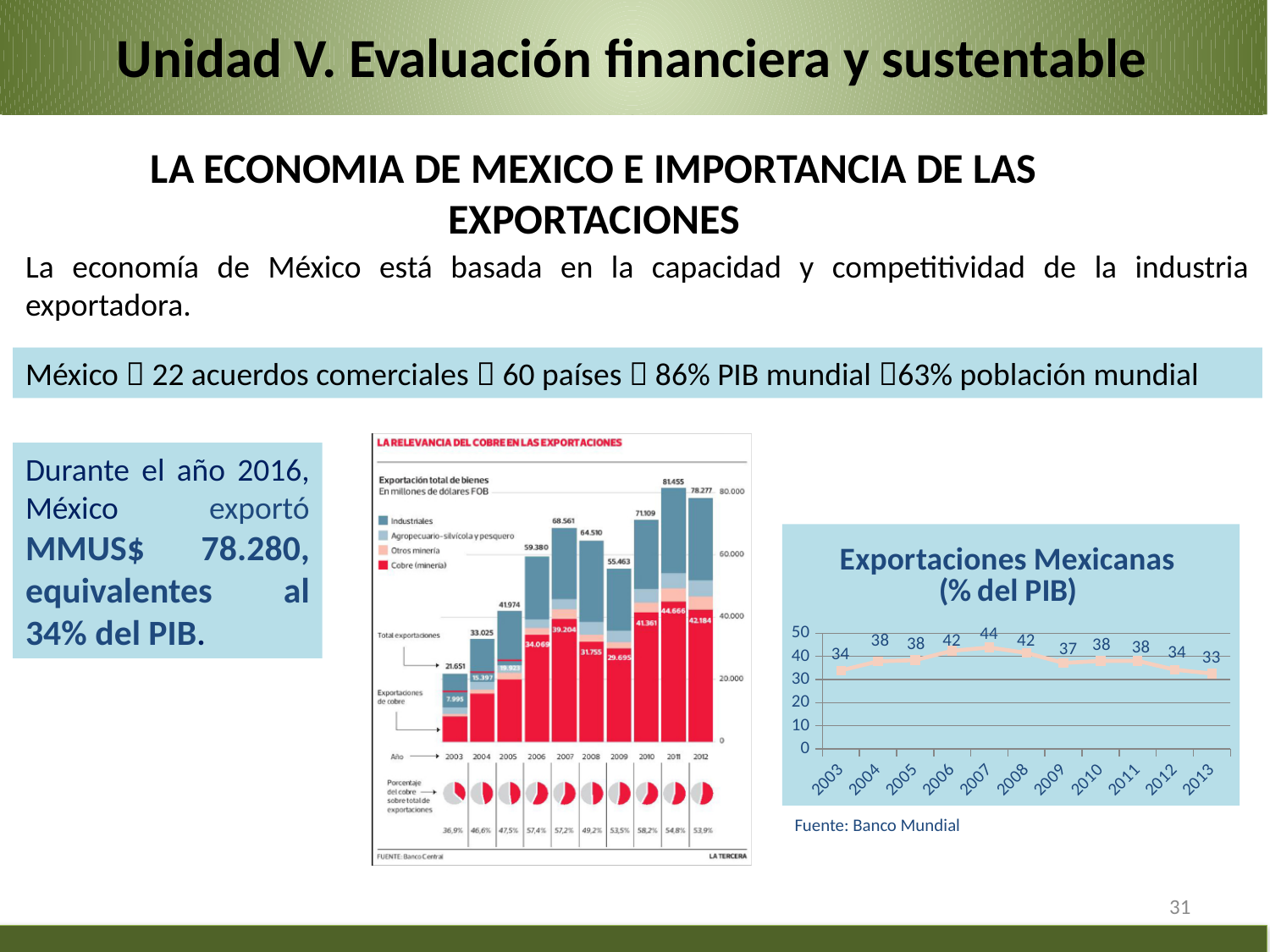
In the 'Exportaciones Mexicanas (% del PIB)' chart, do the values rise or fall from 2007 to 2013? fall What kind of chart is the 'La relevancia del cobre en las exportaciones' chart on the left? bar chart In the 'Exportaciones Mexicanas (% del PIB)' chart, what is the value for 2007? 44 What source is cited below the 'Exportaciones Mexicanas (% del PIB)' chart? Banco Mundial In the 'La relevancia del cobre en las exportaciones' chart on the left, what is the total exports value for 2011? 81.455 In the 'Exportaciones Mexicanas (% del PIB)' chart, what is the difference between the values for 2007 and 2013? 11 What kind of chart is 'Exportaciones Mexicanas (% del PIB)'? line chart In the 'Exportaciones Mexicanas (% del PIB)' chart, which is larger, the value for 2006 or the value for 2009? 2006 How many years are plotted in the 'Exportaciones Mexicanas (% del PIB)' chart? 11 In the 'Exportaciones Mexicanas (% del PIB)' chart, is the value for 2003 greater or less than 30? greater In the 'Exportaciones Mexicanas (% del PIB)' chart, which year has the highest value? 2007 In the 'Exportaciones Mexicanas (% del PIB)' chart, which year has the lowest value? 2013